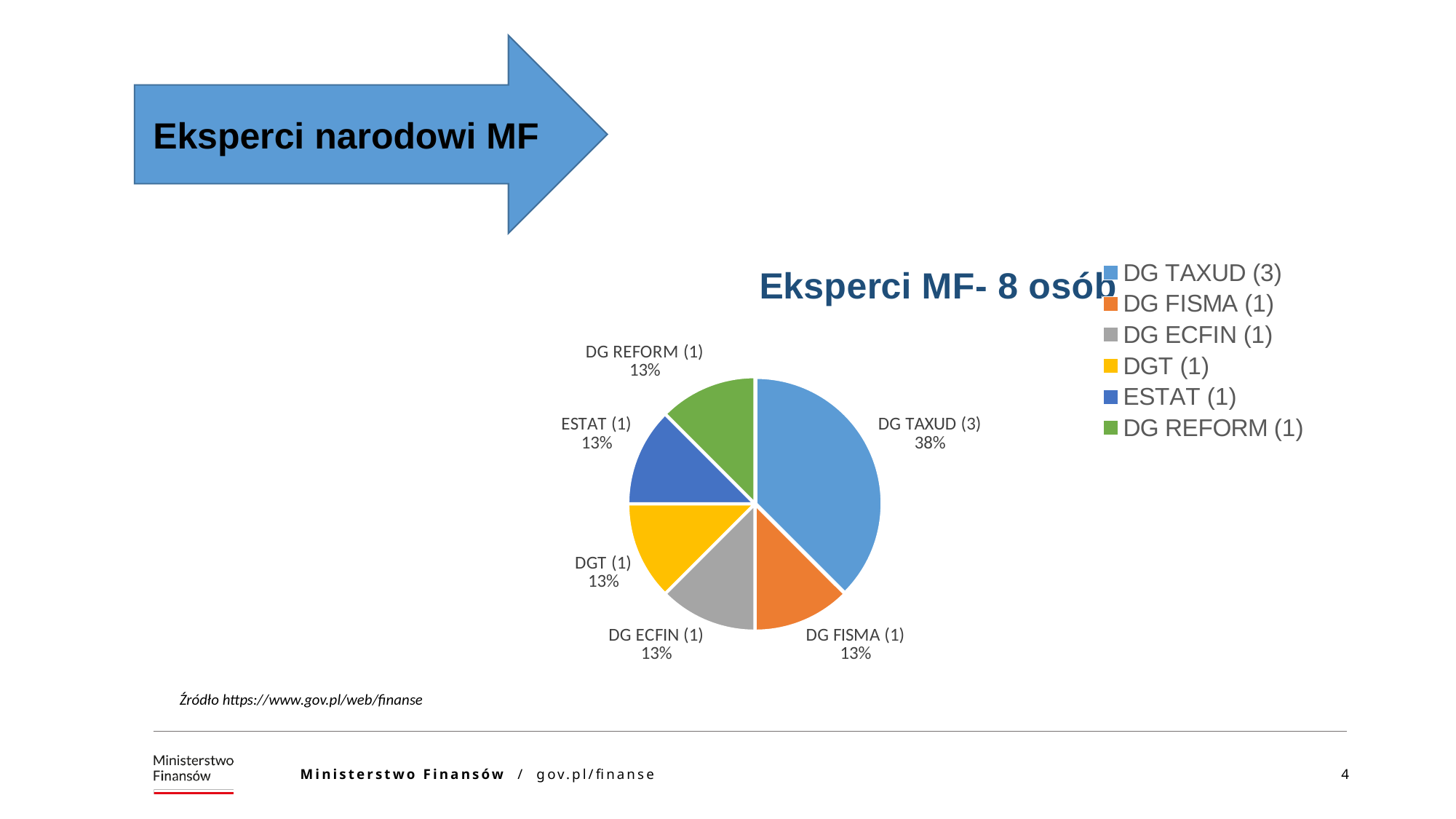
What percentage share does the DG ECFIN (1) slice have? 13% What is the title of the chart? Eksperci MF- 8 osób What percentage share does the DG TAXUD (3) slice have? 38% Which category has the largest slice of the pie? DG TAXUD (3) What percentage share does the DG FISMA (1) slice have? 13% What colour is the DG REFORM (1) slice? green How many entries does the legend list? 6 What kind of chart is shown on the slide? pie chart How many slices does the pie chart have? 6 Which is larger, the DG TAXUD (3) slice or the DGT (1) slice? DG TAXUD (3) What is the difference in percentage points between the DG TAXUD (3) slice and the DG REFORM (1) slice? 25